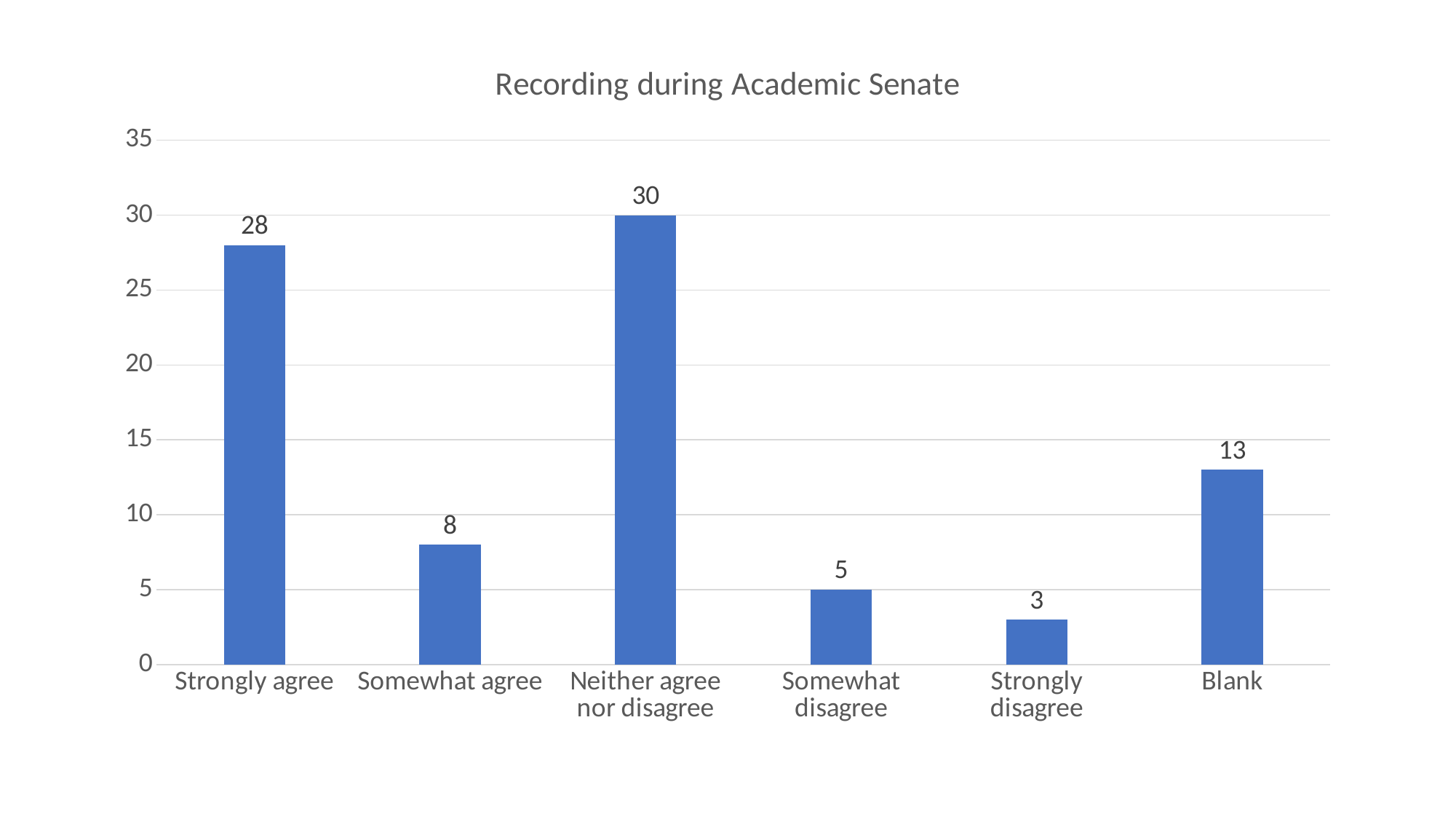
Which category has the lowest value? Strongly disagree What kind of chart is this? Bar chart What is the difference between the values for Neither agree nor disagree and Strongly agree? 2 What is the value for Neither agree nor disagree? 30 Which is larger, the value for Somewhat agree or the value for Somewhat disagree? Somewhat agree What is the difference between the values for Blank and Somewhat agree? 5 What is the value for Strongly disagree? 3 What is the value for Strongly agree? 28 How many categories are shown on the x axis? 6 What is the value for Blank? 13 Which category has the highest value? Neither agree nor disagree What is the title of the chart? Recording during Academic Senate